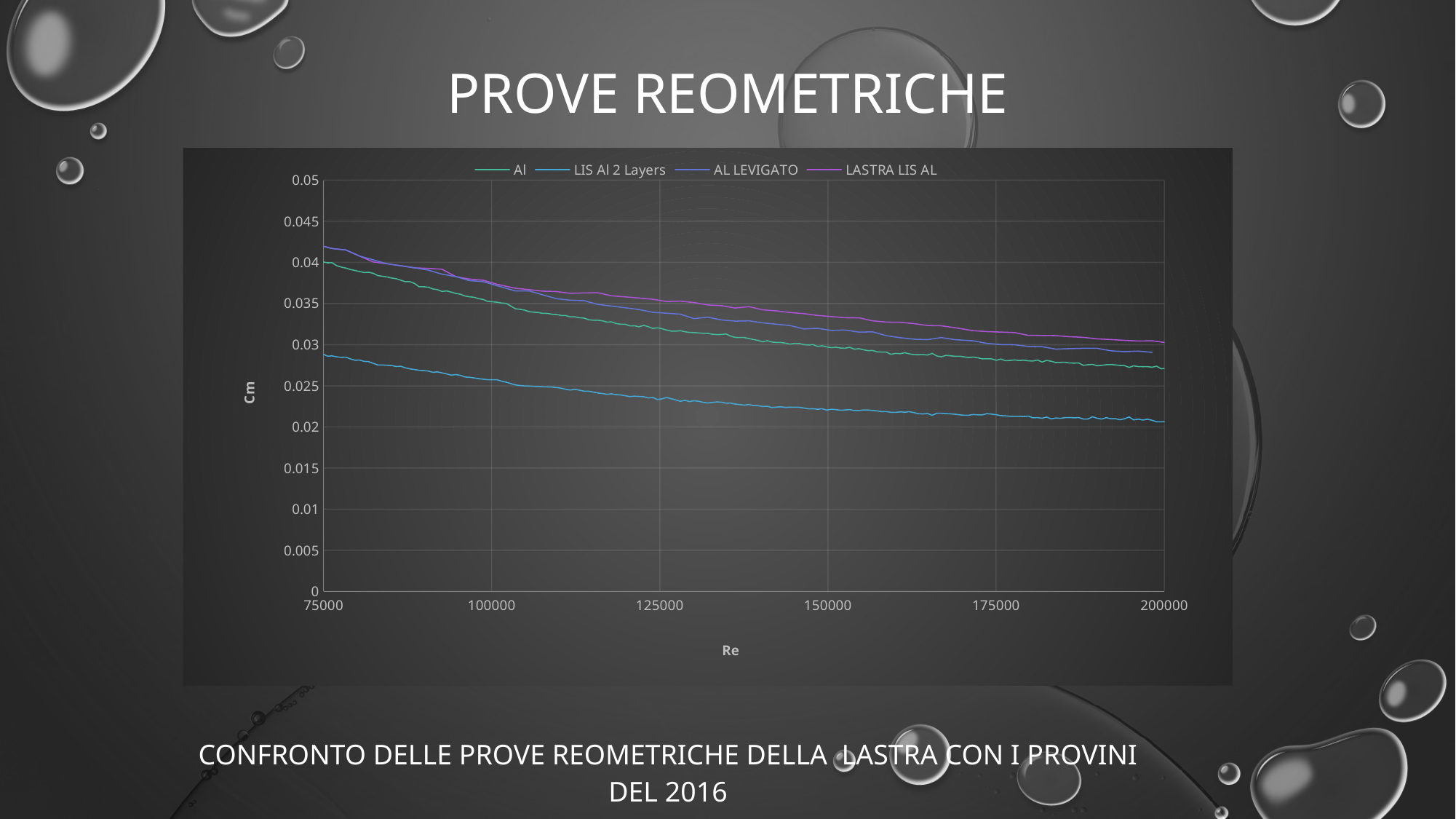
Is the value for LIS Al 2 Layers at Re = 200000 greater or less than 0.025? less Which is larger at Re = 150000, the value for Al or the value for LIS Al 2 Layers? Al Is the value for LASTRA LIS AL at Re = 75000 greater or less than 0.04? greater What is the label of the x axis? Re Is the value for Al at Re = 200000 greater or less than 0.03? less What kind of chart is shown on the slide? line chart How many series does the legend list? 4 Which series has the highest value at Re = 200000? LASTRA LIS AL What is the label of the y axis? Cm Do the values of the Al series rise or fall as Re increases? fall Do the values of the LIS Al 2 Layers series rise or fall as Re increases? fall Which series has the lowest values across the whole Re range? LIS Al 2 Layers